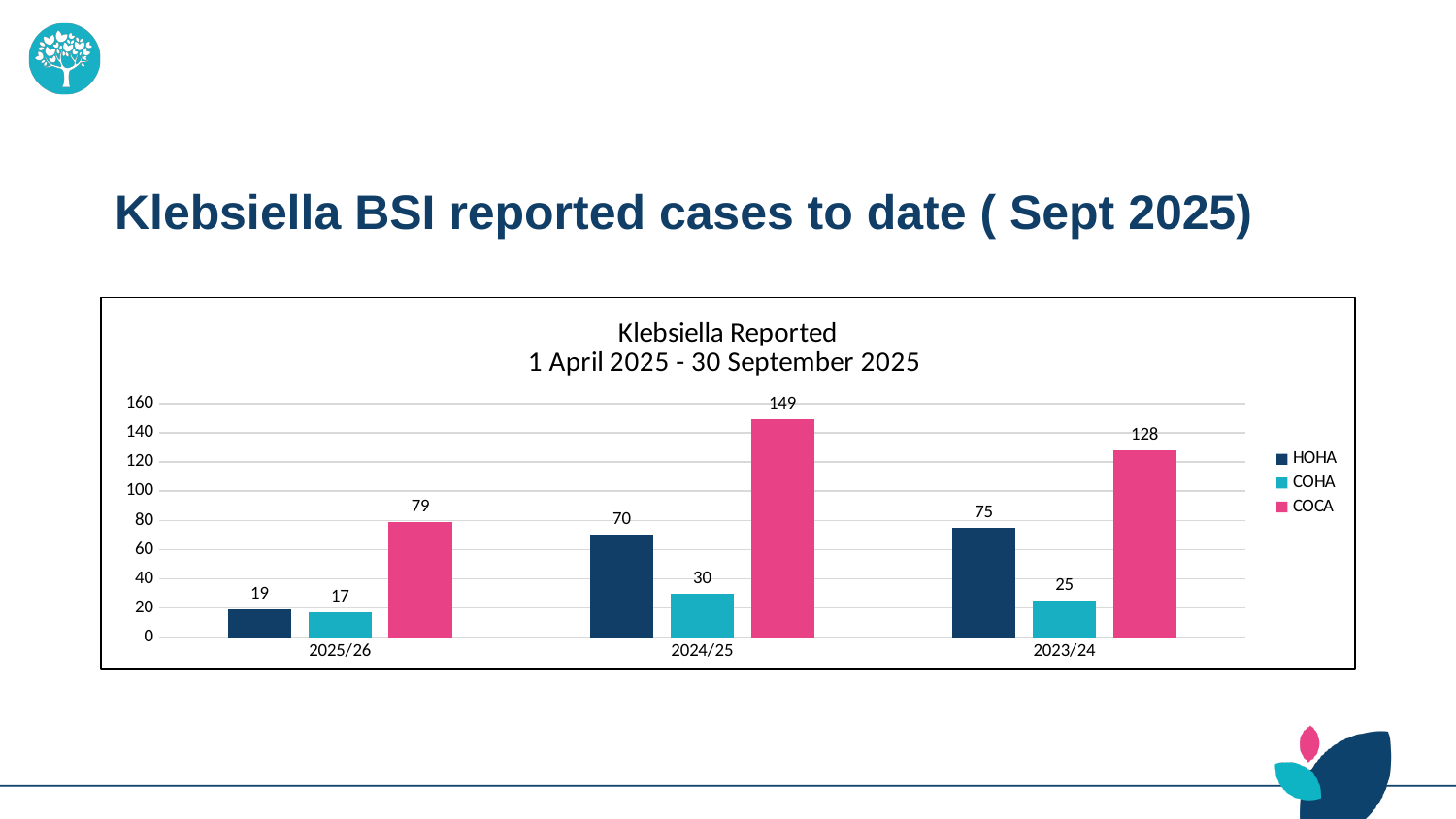
What is the difference between the COCA values for 2024/25 and 2023/24? 21 Which year has the lowest COHA value? 2025/26 Is the COCA value for 2025/26 greater or less than 100? less What is the COCA value for 2024/25? 149 How many year categories are shown on the x axis? 3 What is the COHA value for 2023/24? 25 Which year has the highest COCA value? 2024/25 What kind of chart is shown? bar chart What is the HOHA value for 2025/26? 19 What is the title of the chart? Klebsiella Reported 1 April 2025 - 30 September 2025 How many series does the legend list? 3 Which is larger, the HOHA value for 2024/25 or the HOHA value for 2023/24? 2023/24